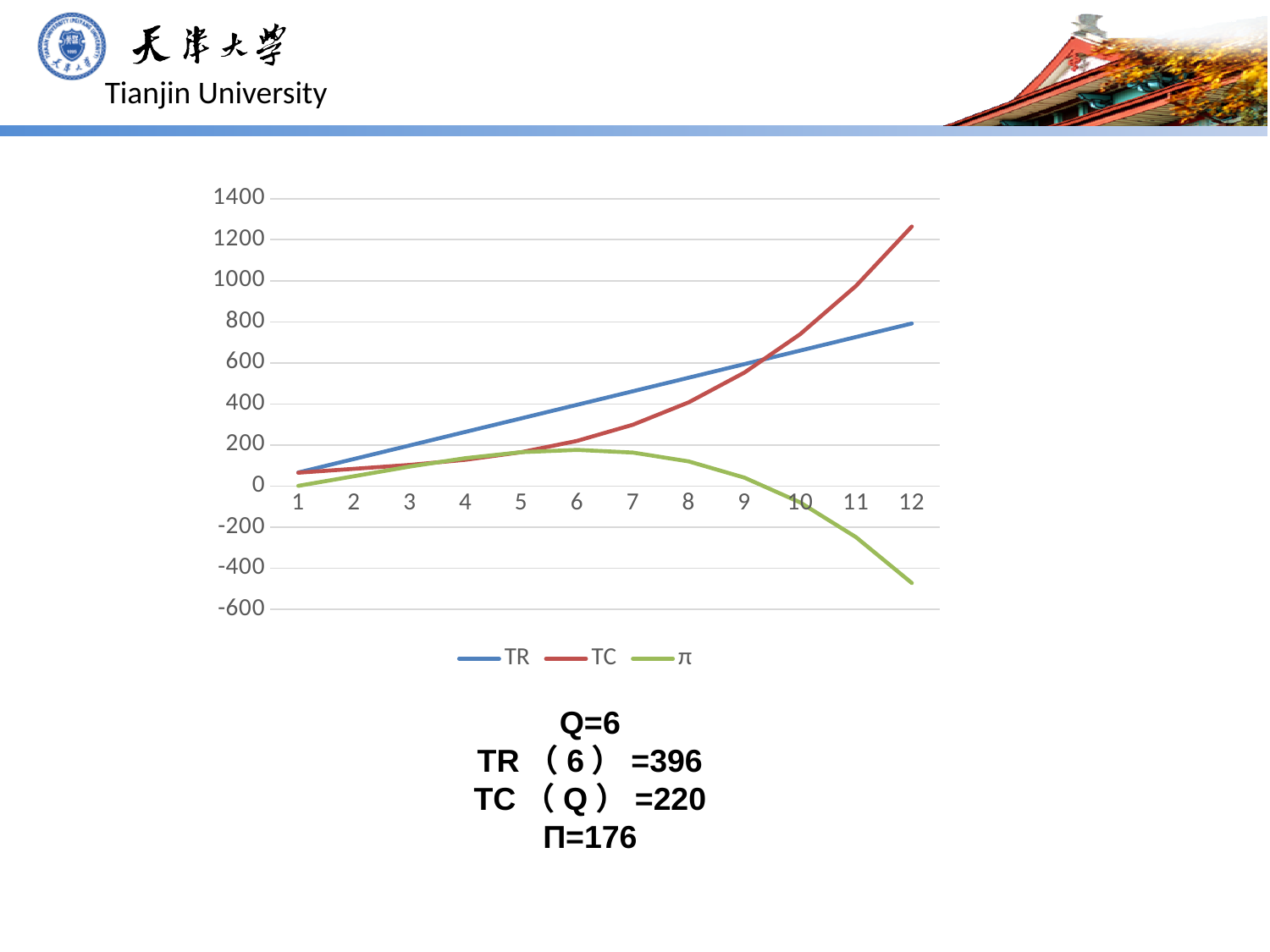
At x = 3, which series has the larger value, TR or TC? TR What are the three series named in the legend? TR, TC, π According to the text below the chart, what is the value of TC at Q=6? 220 Does the TR series rise or fall as x increases from 1 to 12? rise What kind of chart is shown on the slide? line chart Is the value of TC at x = 12 greater or less than 1200? greater How many points are plotted along the x axis for each series? 12 Is the value of π at x = 12 greater or less than -400? less According to the text below the chart, what is the profit Π at Q=6? 176 How many series does the legend list? 3 According to the text below the chart, what is the value of TR at Q=6? 396 At x = 12, which series has the larger value, TR or TC? TC